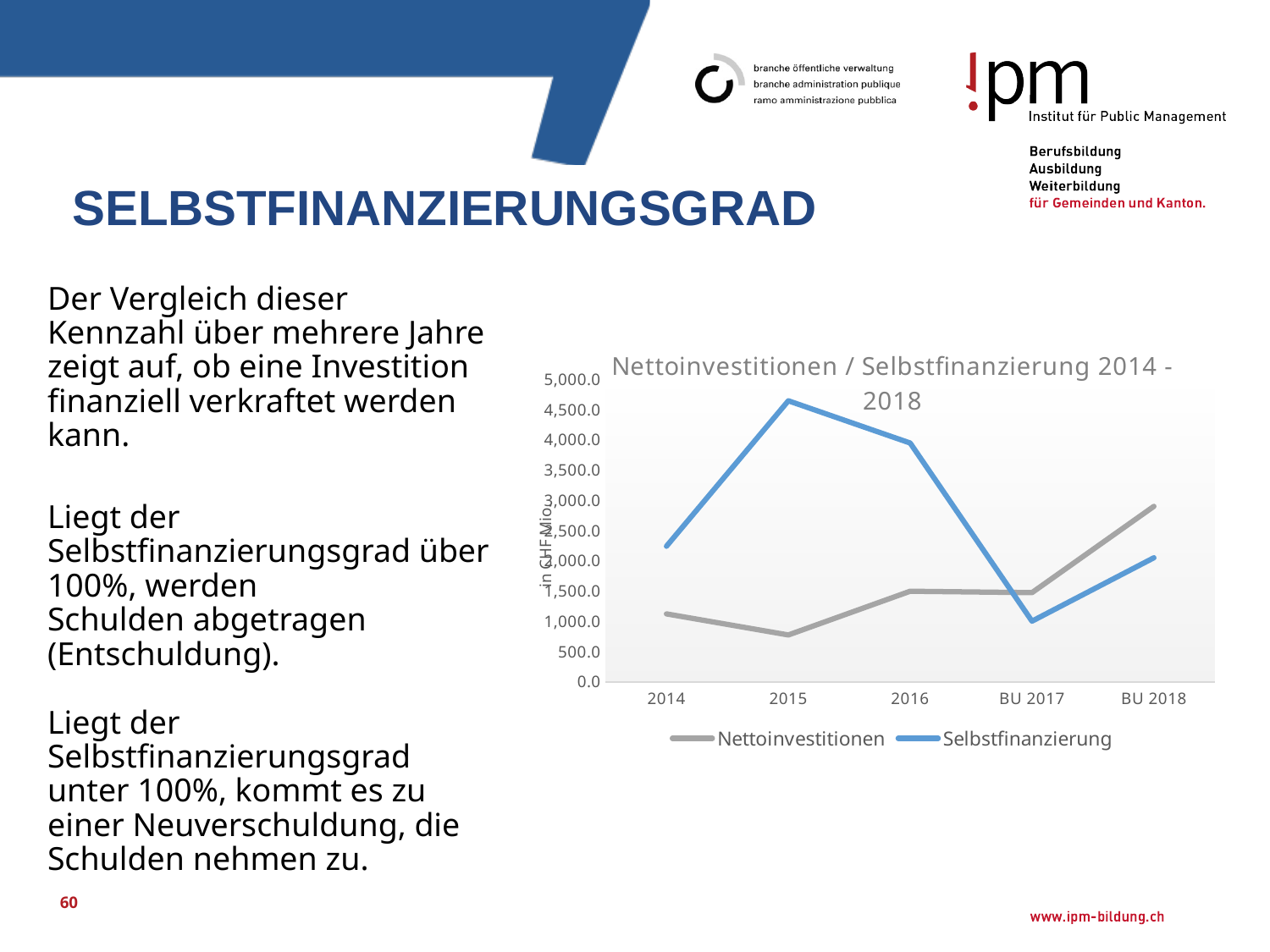
In which year does the Nettoinvestitionen series reach its lowest value? 2015 How many points along the x axis does the chart show? 5 What is the title of the chart? Nettoinvestitionen / Selbstfinanzierung 2014 - 2018 In 2015, which series has the higher value, Nettoinvestitionen or Selbstfinanzierung? Selbstfinanzierung Is the value for Nettoinvestitionen in 2015 greater or less than 1,000.0? less In BU 2018, which series has the higher value, Nettoinvestitionen or Selbstfinanzierung? Nettoinvestitionen In which year does the Selbstfinanzierung series reach its lowest value? BU 2017 In which year does the Selbstfinanzierung series reach its highest value? 2015 In which year does the Nettoinvestitionen series reach its highest value? BU 2018 What kind of chart is shown on the slide? line chart Is the value for Selbstfinanzierung in 2015 greater or less than 4,000.0? greater How many series does the legend of the chart list? 2